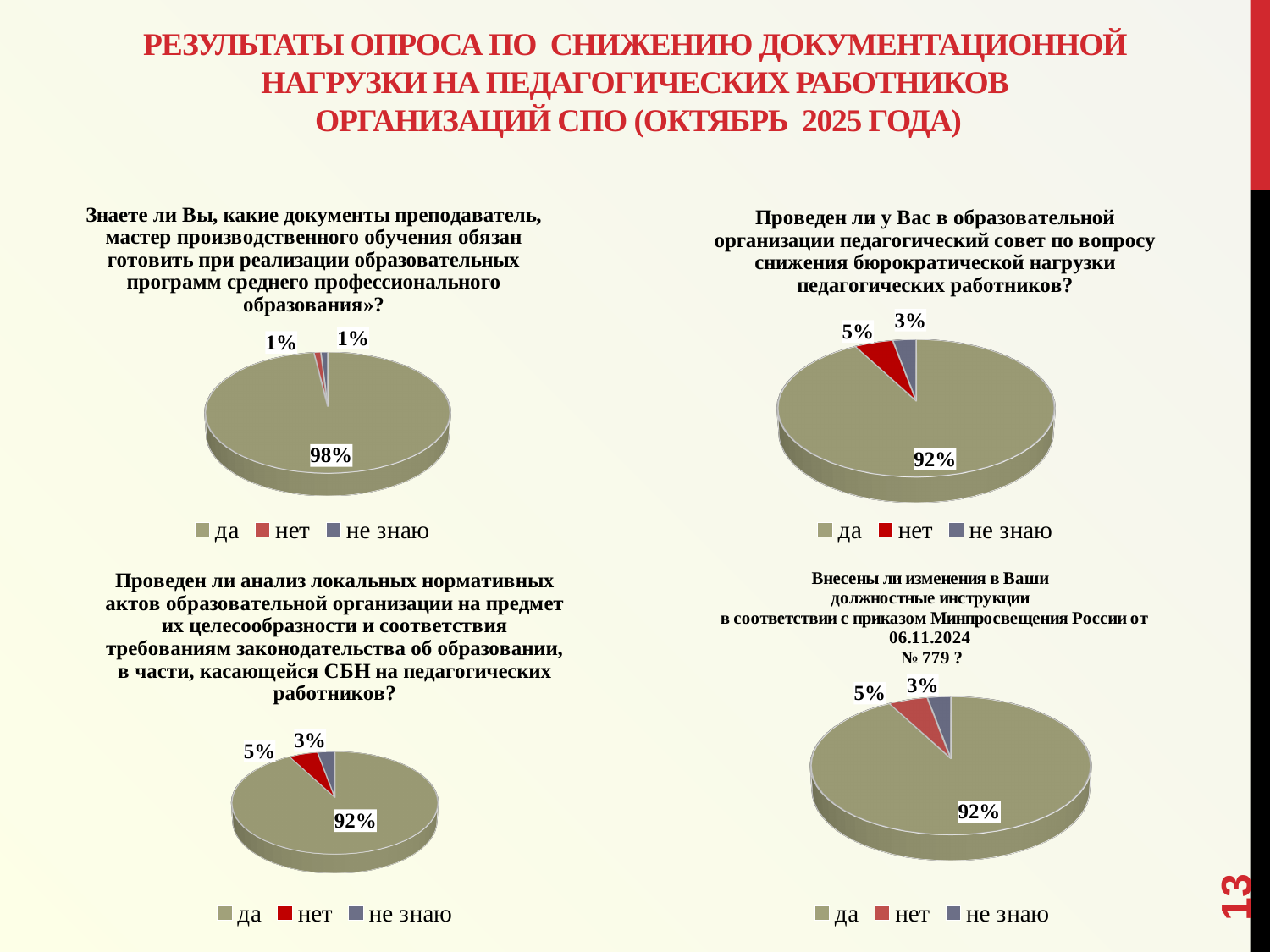
In the bottom-right pie chart (about changes to job descriptions), what share answered "нет"? 5% In the top-left pie chart (about knowing which documents a teacher must prepare), what share of respondents answered "да"? 98% In the bottom-right pie chart, which answer has the largest share? да In the top-left pie chart, is the share for "да" larger or smaller than the share for "нет"? larger How many entries does the legend of the top-left pie chart list? 3 How many pie charts are shown on the slide? 4 In the bottom-left pie chart, which answer has the smallest share? не знаю In the bottom-left pie chart (about analysis of local normative acts), what share answered "да"? 92% In the top-right pie chart, what share answered "не знаю"? 3% In the top-left pie chart, what share of respondents answered "не знаю"? 1% In the top-right pie chart (about whether a pedagogical council was held), what share answered "нет"? 5% In the top-right pie chart, what is the difference between the shares for "да" and "нет"? 87%